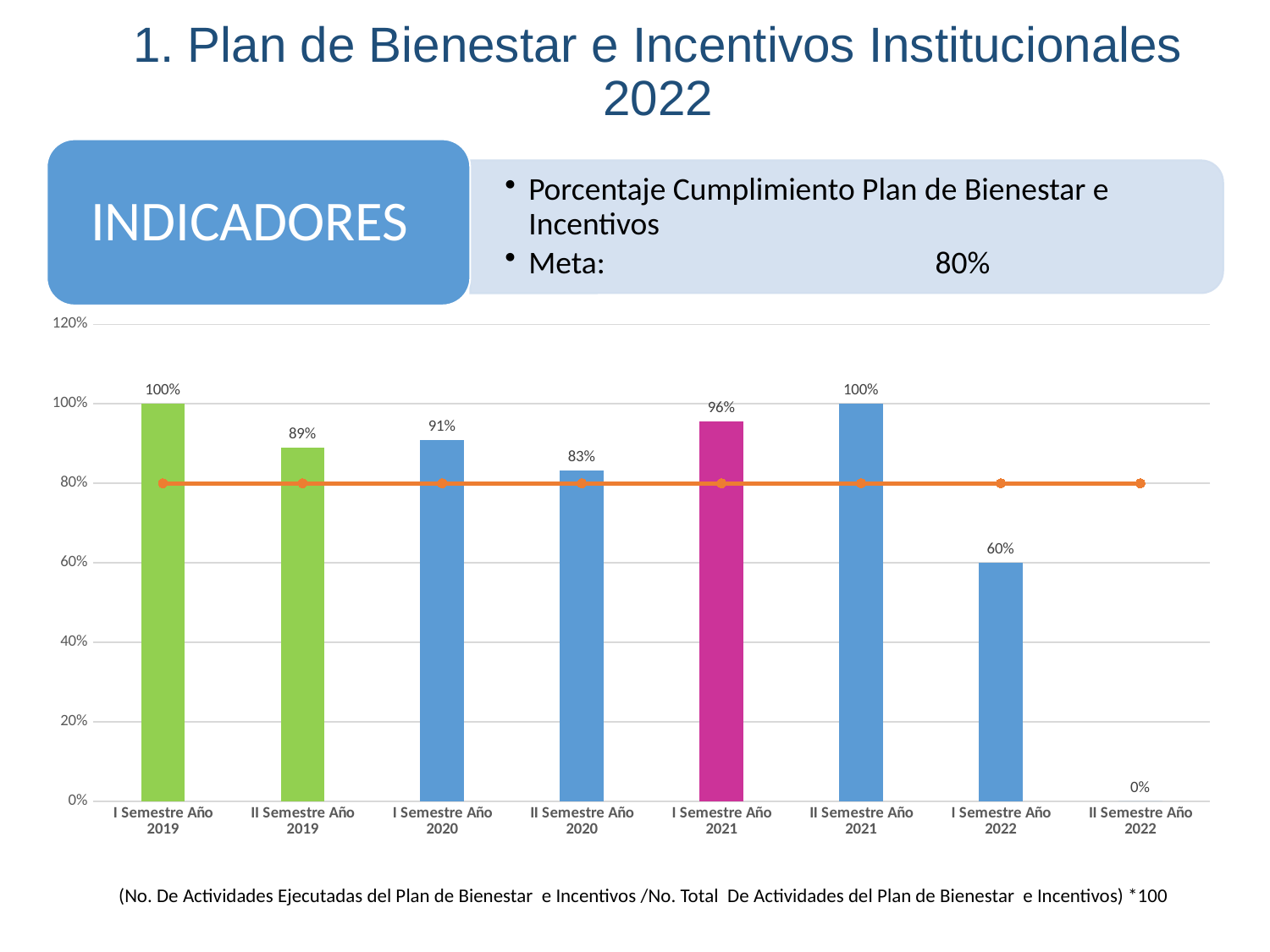
Is the value for I Semestre Año 2022 greater or less than 80%? less Which is larger, the value for II Semestre Año 2019 or the value for I Semestre Año 2021? I Semestre Año 2021 What is the difference between the values for I Semestre Año 2020 and II Semestre Año 2020? 8 percentage points What is the difference between the values for II Semestre Año 2021 and I Semestre Año 2022? 40 percentage points What is the value for I Semestre Año 2021? 96% What kind of chart is shown on the slide? bar chart with a line At what value does the horizontal orange line sit? 80% How many categories are shown on the x axis? 8 Which category has the lowest value? II Semestre Año 2022 What is the value for II Semestre Año 2020? 83% What is the value for I Semestre Año 2022? 60% What is the value for I Semestre Año 2020? 91%